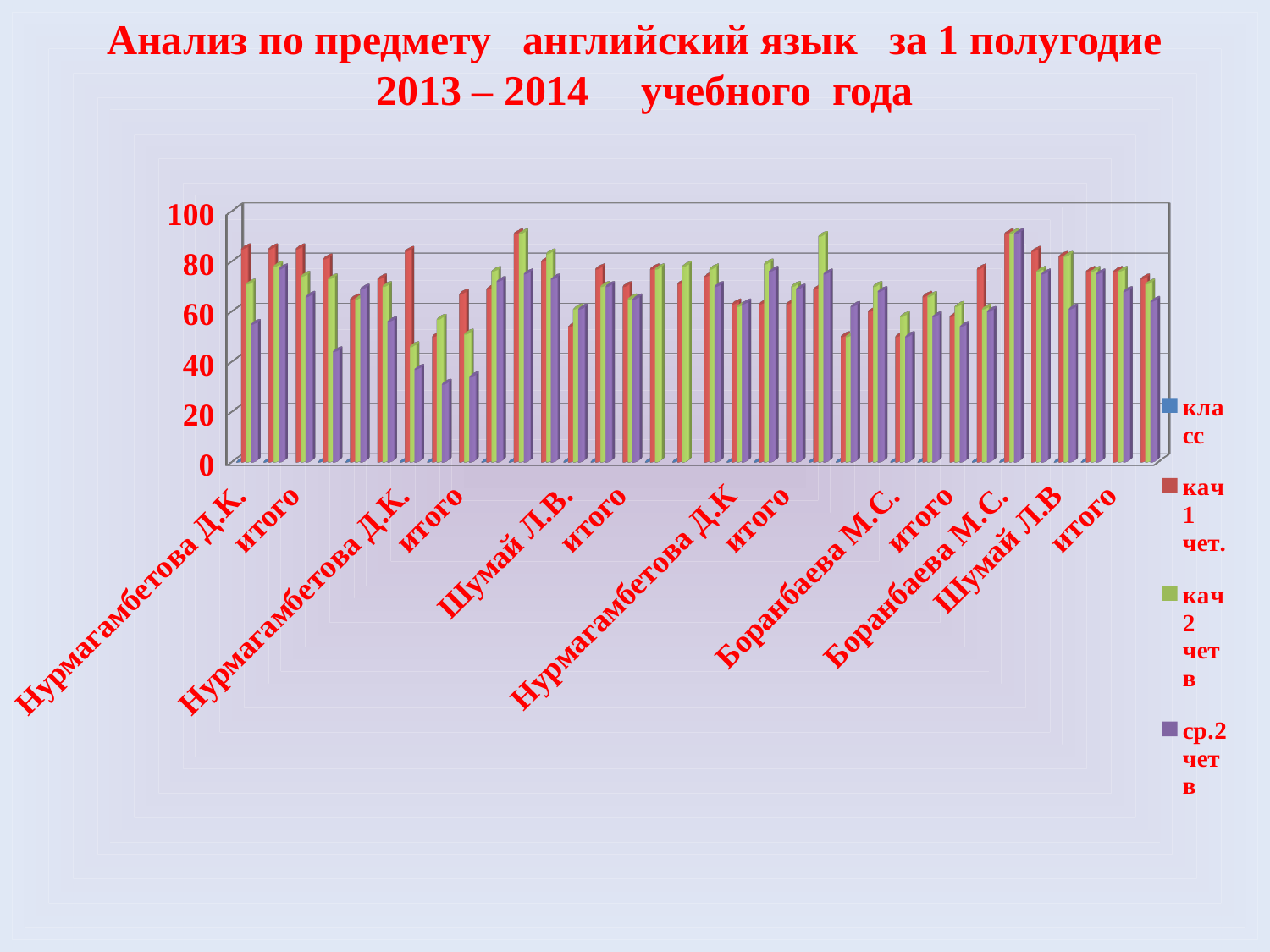
How many series does the legend list? 4 What is the highest value shown on the vertical axis of the chart? 100 What kind of chart is shown on the slide? bar chart Is the tallest bar on the chart greater or less than 80? greater What is the first entry in the chart's legend? класс